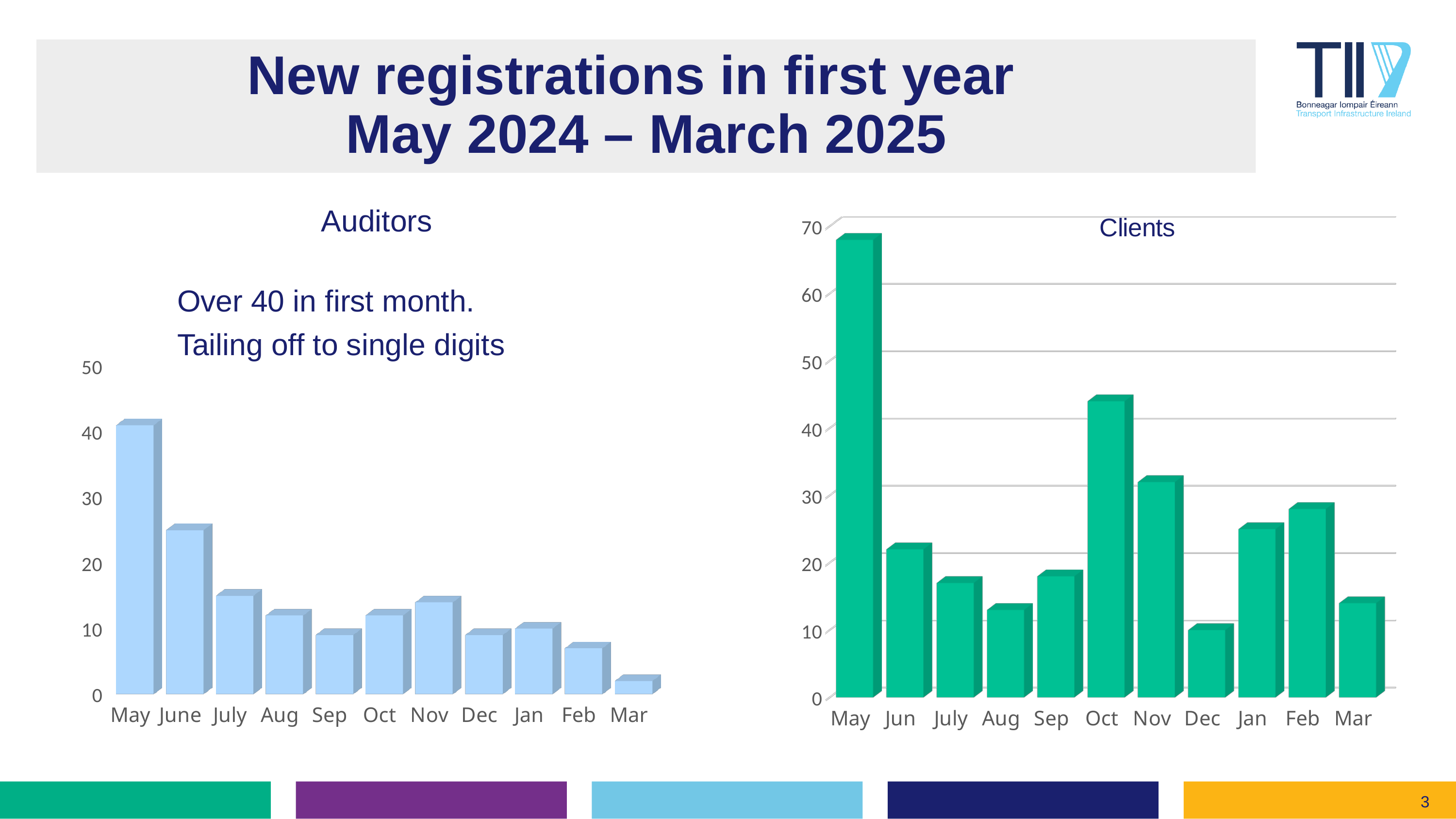
In the Auditors chart, which month has the lowest value? Mar What kind of chart is the Clients chart? Bar chart In the Auditors chart, which is larger, the value for June or the value for Nov? June In the Clients chart, is the value for Oct greater or less than 40? greater In the Clients chart, which month has the highest value? May In the Clients chart, which is larger, the value for Nov or the value for Jan? Nov In the Clients chart, is the value for Aug greater or less than 20? less How many months are shown on the x axis of the Auditors chart? 11 What is the highest tick value on the vertical axis of the Clients chart? 70 In the Auditors chart, which month has the highest value? May In the Clients chart, which month has the lowest value? Dec